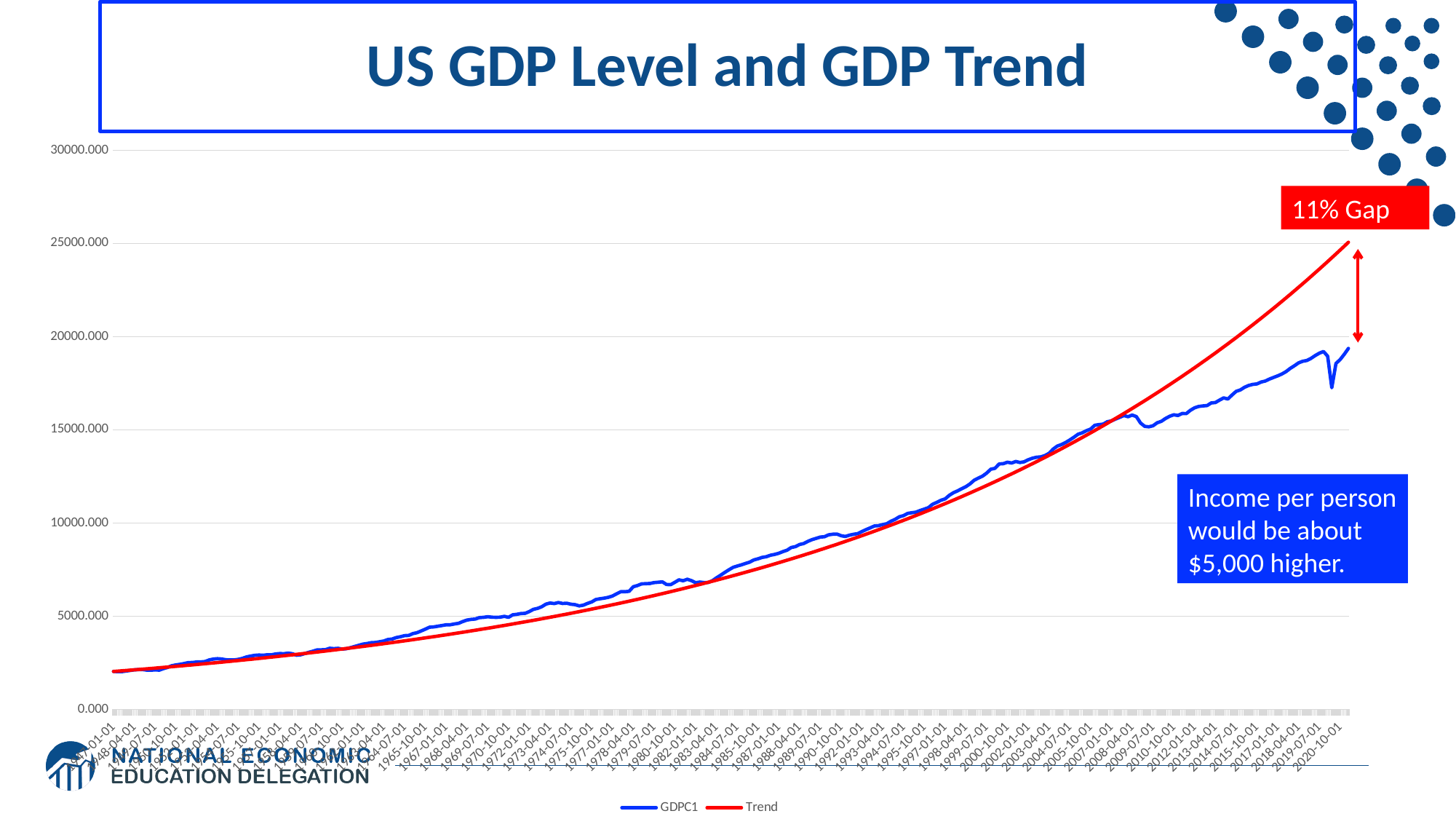
What kind of chart is shown on the slide? line chart Around 1979-07-01, which series has the higher value, GDPC1 or Trend? GDPC1 Is the value of the Trend series at 2020-10-01 greater or less than 20000.000? greater Which series reaches the highest value on the chart? Trend How many series does the legend list? 2 What percentage gap between the two series is labelled at the right end of the chart? 11% Gap What are the two series named in the legend? GDPC1 and Trend Is the value of the GDPC1 series at 1948-01-01 greater or less than 5000.000? less Do the values of the Trend series rise or fall along the x axis? rise Is the value of the GDPC1 series at 2020-10-01 greater or less than 15000.000? greater At the right end of the chart (2020-10-01), which series has the higher value, GDPC1 or Trend? Trend What is the title of the chart? US GDP Level and GDP Trend